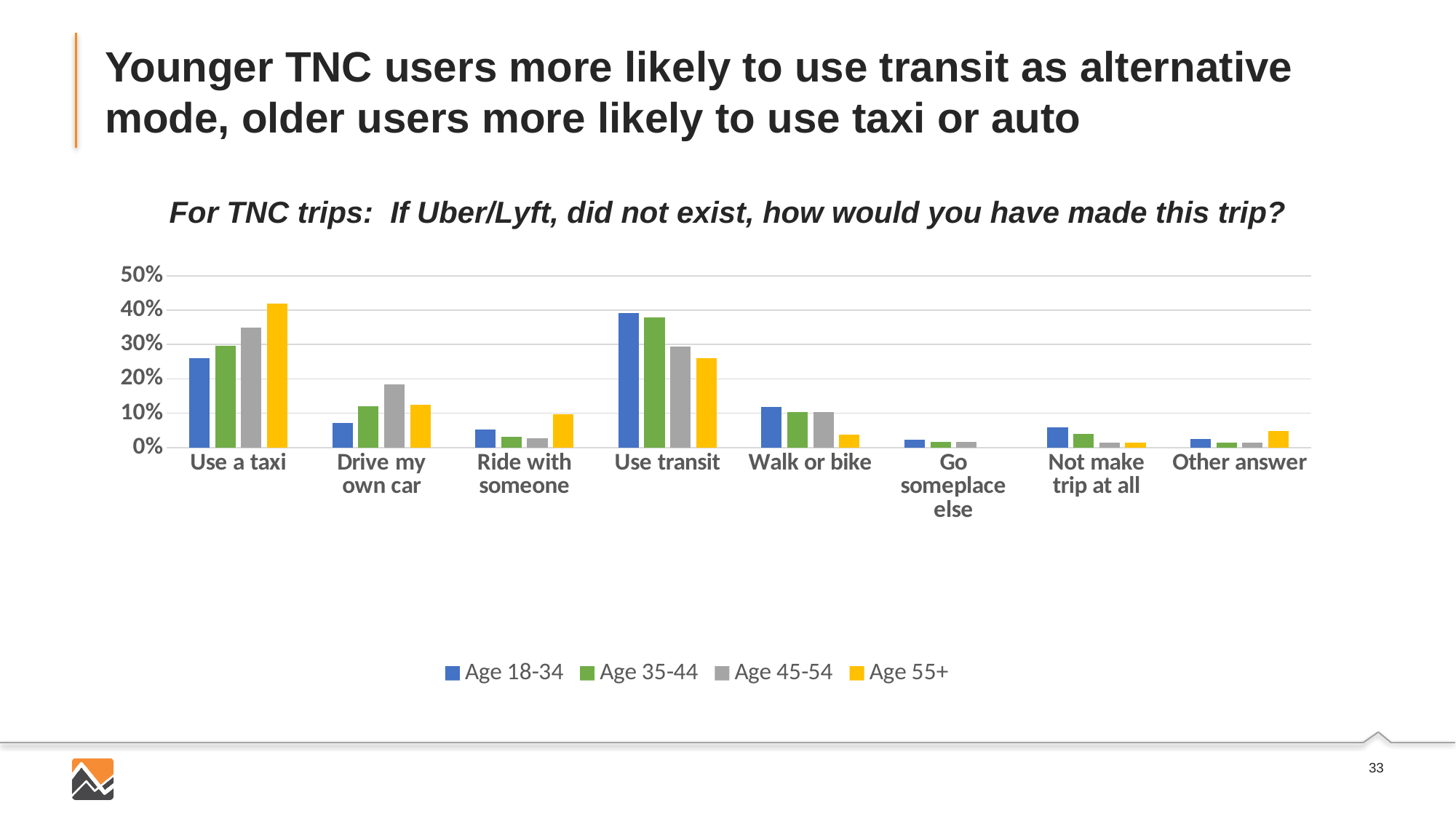
Which response category has the tallest bar for Age 55+? Use a taxi For "Use a taxi", which age group has the highest value? Age 55+ Is the value for Age 55+ under "Walk or bike" greater or less than 10%? less What kind of chart is shown on the slide? Bar chart For "Use transit", which is larger: Age 18-34 or Age 55+? Age 18-34 For "Drive my own car", which is larger: Age 45-54 or Age 18-34? Age 45-54 For "Ride with someone", which age group has the highest value? Age 55+ How many age groups does the legend list? 4 Is the value for Age 55+ under "Use a taxi" greater or less than 30%? greater Is the value for Age 18-34 under "Use transit" greater or less than 30%? greater For "Walk or bike", which age group has the lowest value? Age 55+ How many response categories are shown along the x axis? 8